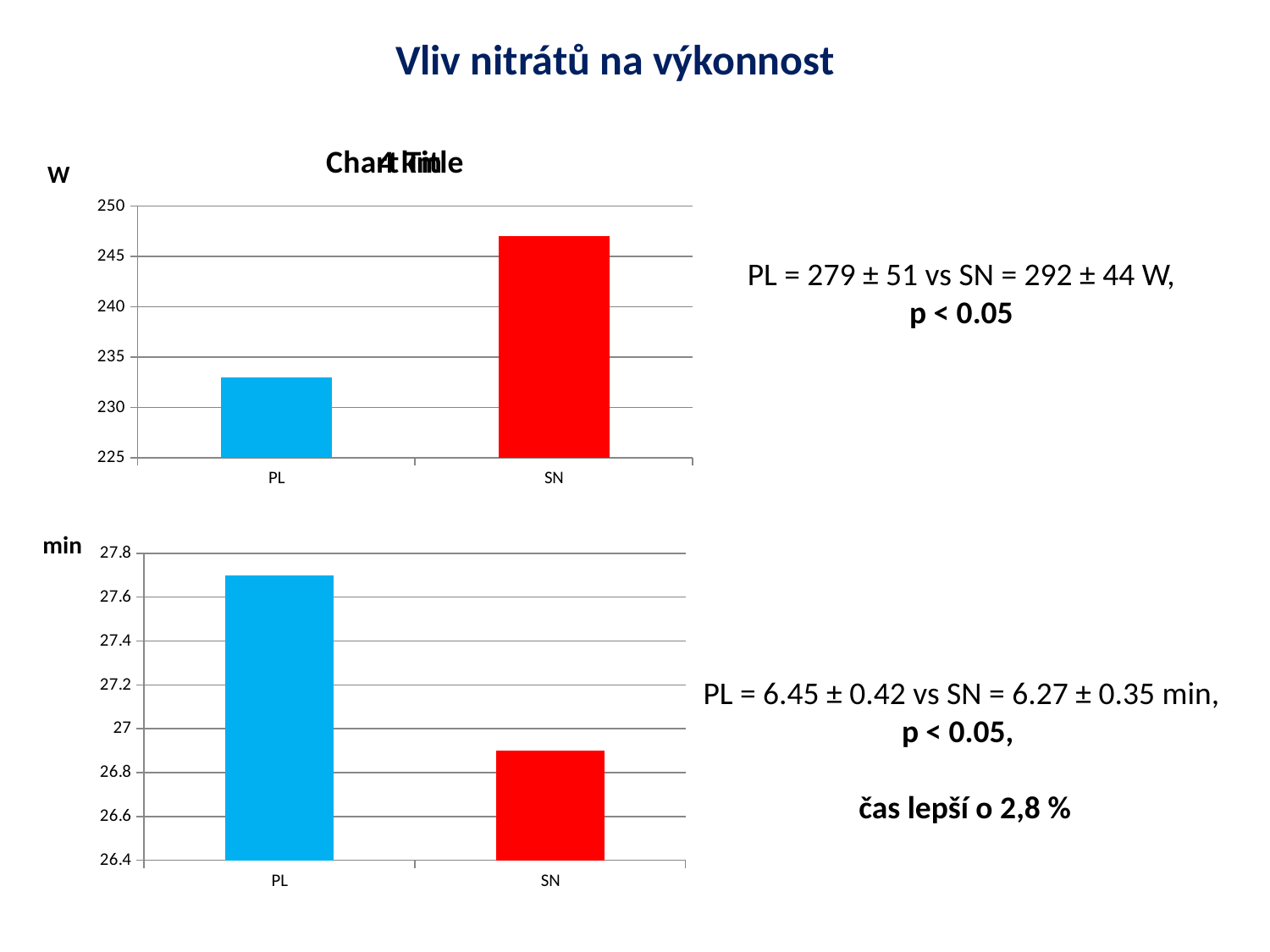
What type of chart is the top chart? bar chart What unit label is shown on the vertical axis of the bottom chart? min In the top chart, is the value for SN greater or less than 245? greater What unit label is shown on the vertical axis of the top chart? W In the top chart, which category has the higher bar, PL or SN? SN In the bottom chart, is the value for PL greater or less than 27.6? greater In the top chart, is the value for PL greater or less than 235? less In the bottom chart, which of PL and SN has the smaller value? SN How many categories are shown in the top chart? 2 In the top chart, which category has the lowest bar? PL In the bottom chart, which category has the highest bar? PL